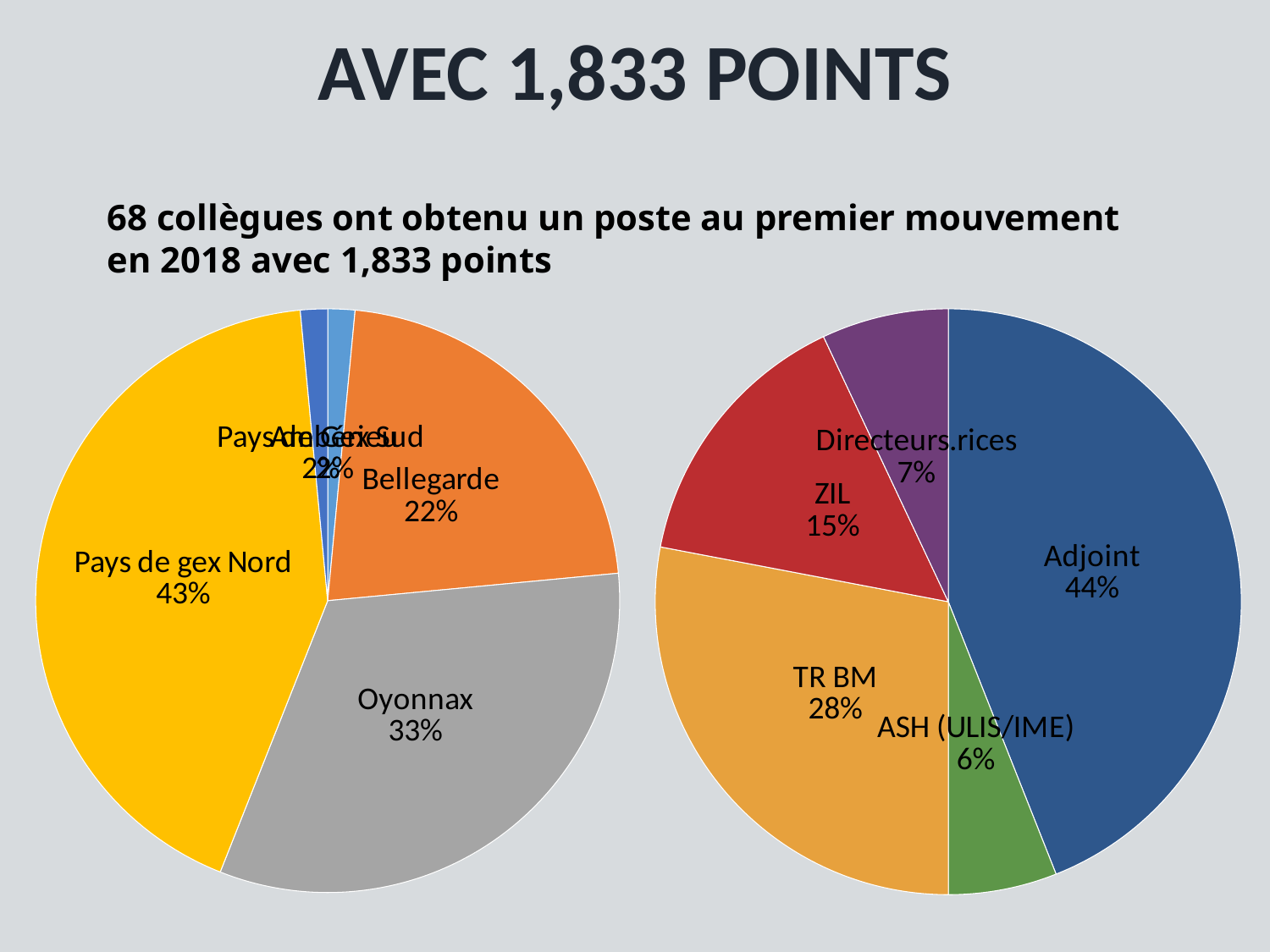
In the right pie chart, which slice is the smallest? ASH (ULIS/IME) In the left pie chart, what is the difference between the shares of Pays de gex Nord and Oyonnax? 10 percentage points In the right pie chart, what share does Adjoint have? 44% In the left pie chart, what share does Oyonnax have? 33% In the left pie chart, what share does Bellegarde have? 22% In the right pie chart, which is larger, Directeurs.rices or ZIL? ZIL How many slices does the right pie chart have? 5 What kind of charts are shown on the slide? Pie charts In the left pie chart, which slice is the largest? Pays de gex Nord